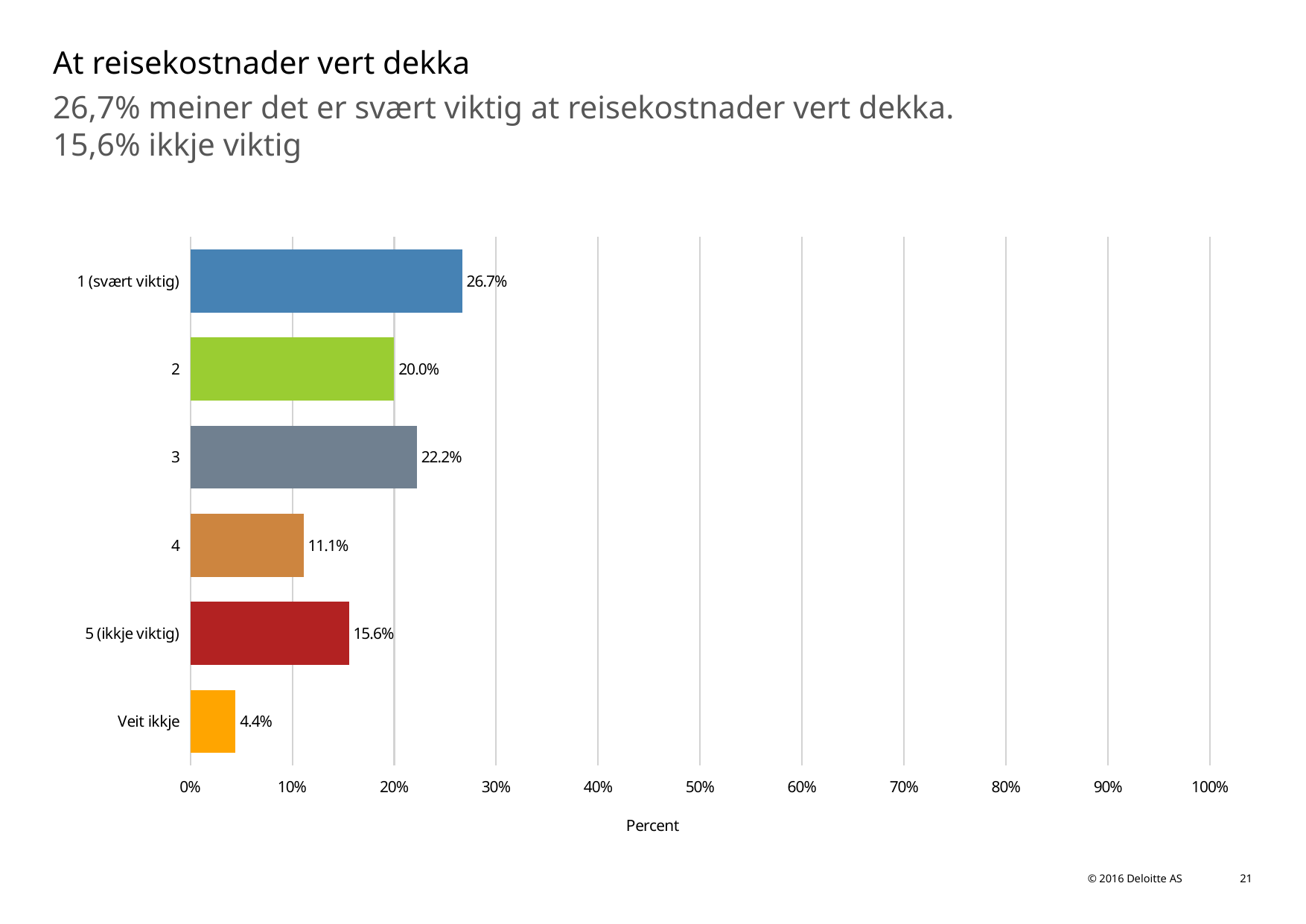
Which category has the lowest value? Veit ikkje What is the value for "1 (svært viktig)"? 26.7% What colour is the bar for "5 (ikkje viktig)"? red What is the difference between the values for "1 (svært viktig)" and "5 (ikkje viktig)"? 11.1% Which is larger, the value for category 2 or category 3? 3 Is the value for category 4 greater or less than 20%? less What is the label of the horizontal axis? Percent Which category has the highest value? 1 (svært viktig) What is the value for "Veit ikkje"? 4.4% How many categories are shown in the chart? 6 What is the value for category 3? 22.2% What kind of chart is shown on the slide? bar chart